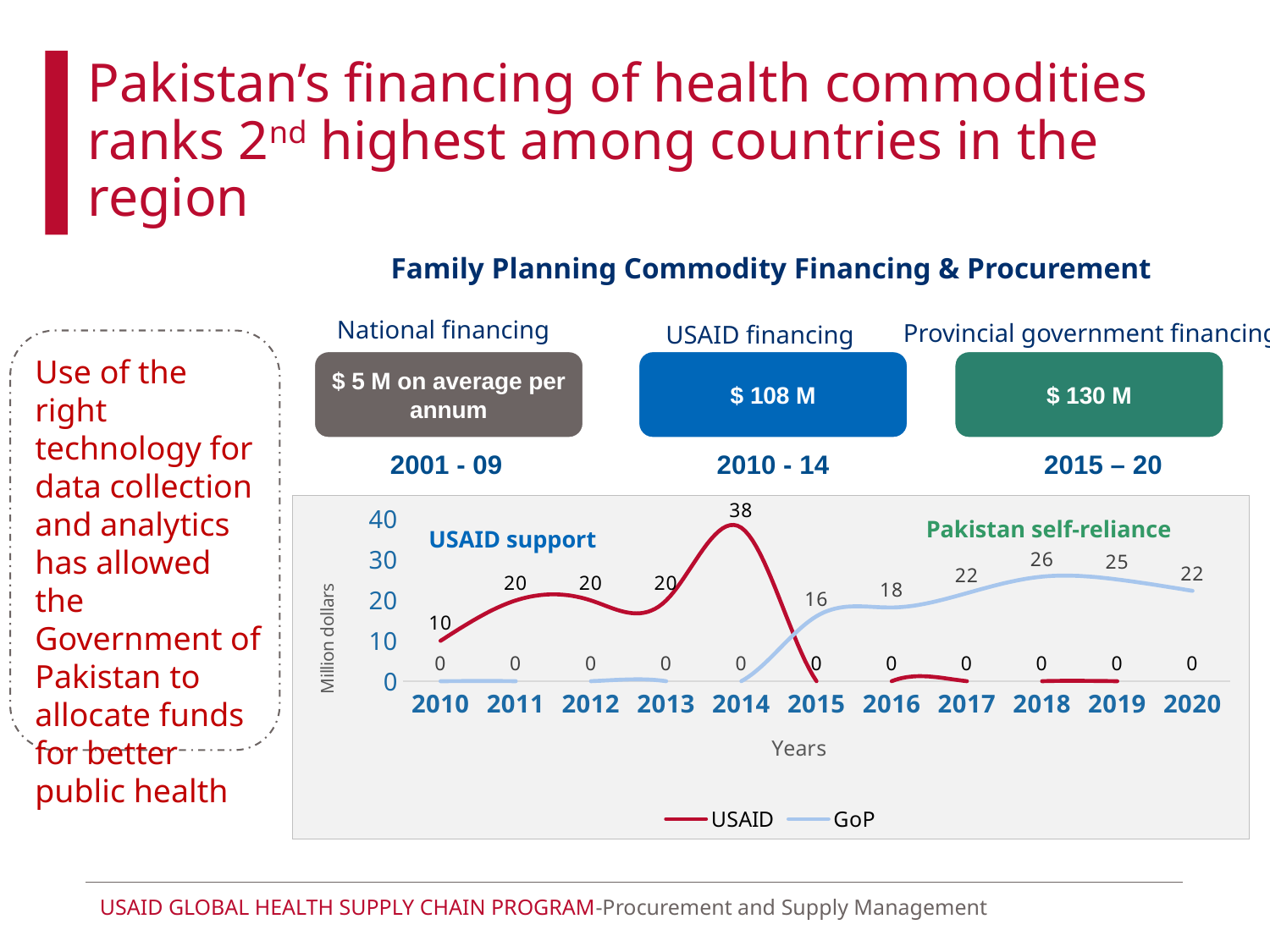
How many series does the chart legend list? 2 What is the GoP value for 2018? 26 What is the USAID value for 2010? 10 Which is larger, the GoP value in 2017 or the GoP value in 2020? They are equal (22) What is the GoP value for 2015? 16 In which year does the GoP series reach its highest value? 2018 What is the difference between the USAID value in 2014 and the USAID value in 2013? 18 In which year does the USAID series reach its highest value? 2014 What is the USAID value for 2014? 38 What is the label of the y axis? Million dollars What type of chart is shown on the slide? line chart How many years are shown on the x axis? 11